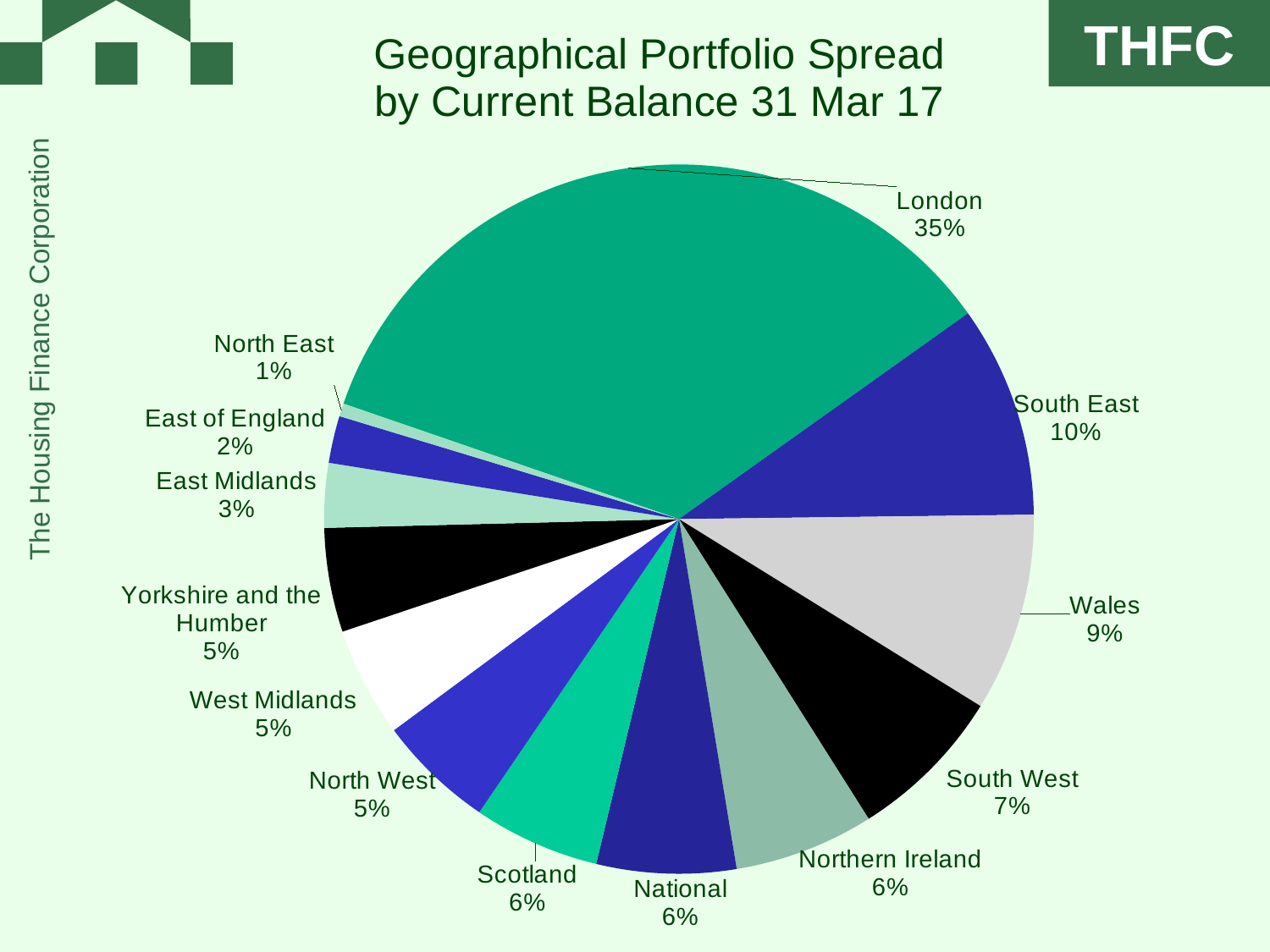
What percentage is shown for Yorkshire and the Humber? 5% What is the combined share of Scotland and National? 12% What is the difference in percentage points between London and South East? 25 How many regions are shown in the pie chart? 13 Which region has the smallest slice of the pie? North East What percentage is shown for East of England? 2% What share of the portfolio does London account for? 35% What percentage is shown for Wales? 9% What kind of chart is shown on the slide? pie chart Which is larger, the share for South West or the share for East Midlands? South West Which region has the largest slice of the pie? London What is the title of the chart? Geographical Portfolio Spread by Current Balance 31 Mar 17